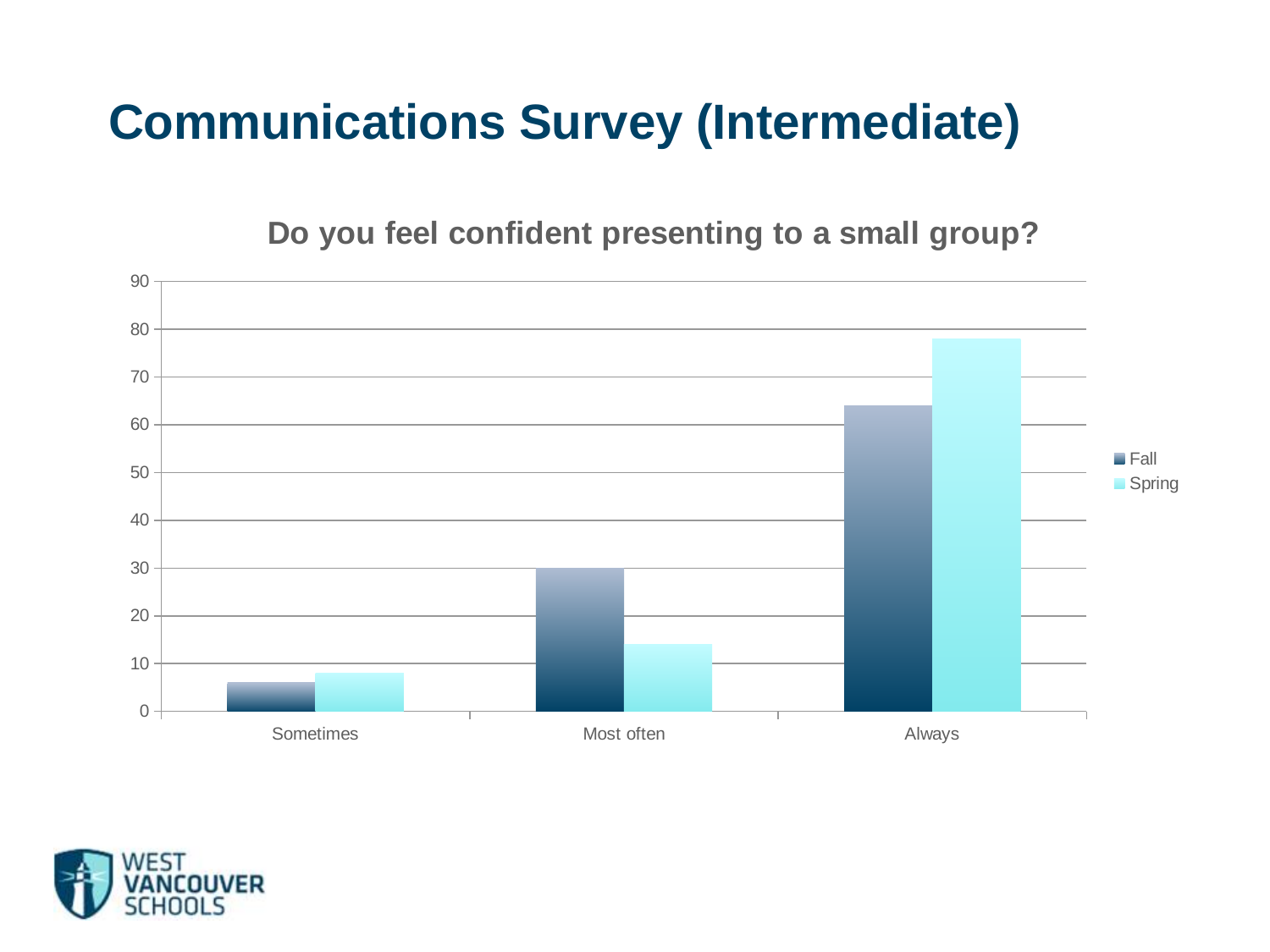
For "Always", which is larger, Fall or Spring? Spring Which category has the lowest Fall value? Sometimes For "Most often", which is larger, Fall or Spring? Fall Is the Spring value for "Always" greater or less than 70? greater Which category and series has the highest bar? Always, Spring How many categories are shown on the x axis? 3 Do the Fall values rise or fall moving from "Sometimes" to "Always"? Rise What is the title of the chart? Do you feel confident presenting to a small group? Is the Spring value for "Most often" greater or less than 20? less What kind of chart is shown on the slide? Bar chart How many series does the legend list? 2 What is the Fall value for "Most often"? 30